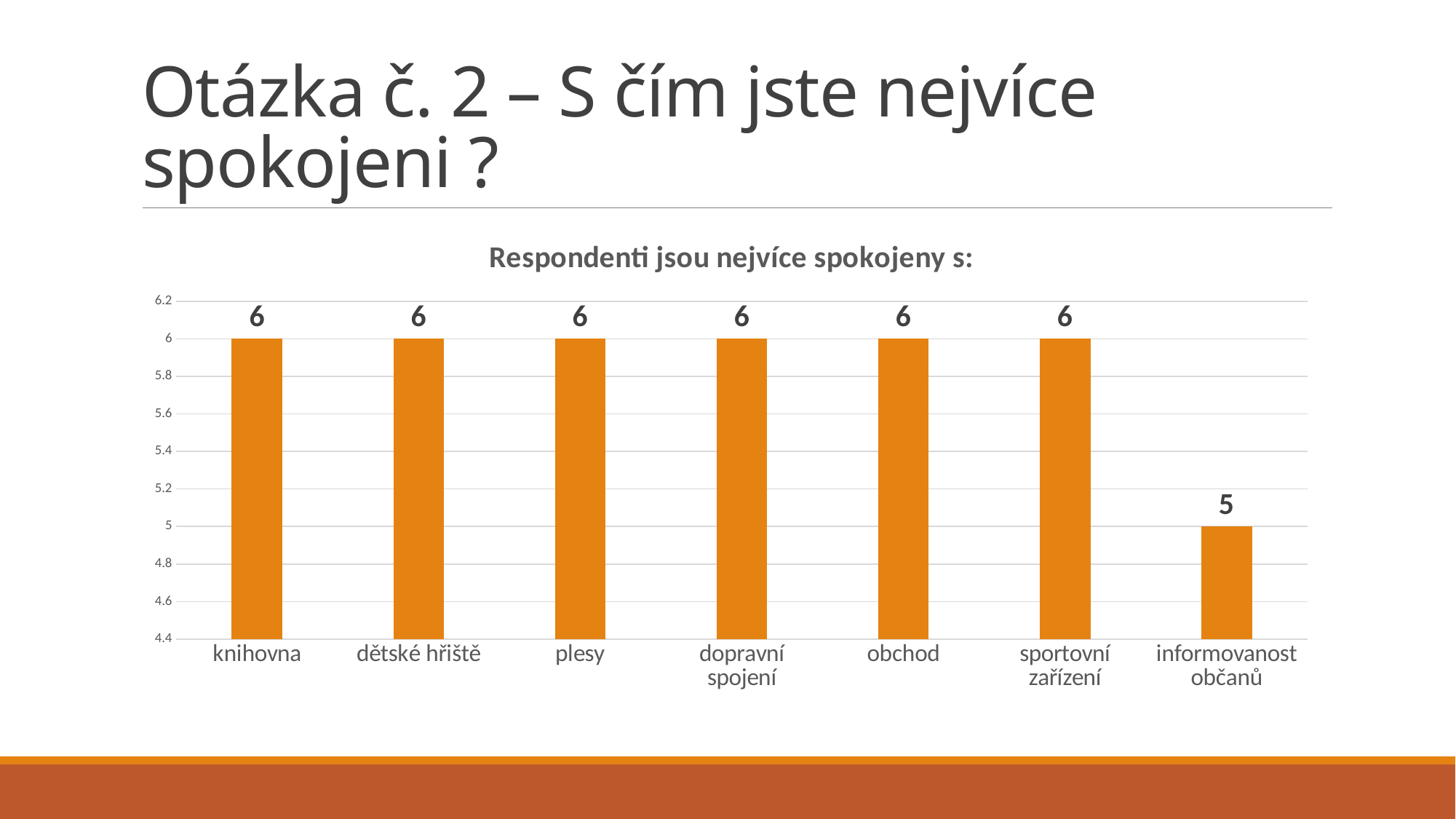
What kind of chart is shown on the slide? bar chart Is the value for informovanost občanů greater or less than 5.4? less Is the value for plesy greater or less than 5.8? greater What is the value for dopravní spojení? 6 Which is larger, the value for sportovní zařízení or the value for informovanost občanů? sportovní zařízení Which category has the lowest value? informovanost občanů What is the value for informovanost občanů? 5 What is the title of the chart? Respondenti jsou nejvíce spokojeny s: What is the value for knihovna? 6 What is the difference between the values for obchod and informovanost občanů? 1 How many categories are shown in the chart? 7 How many categories have a value of 6? 6